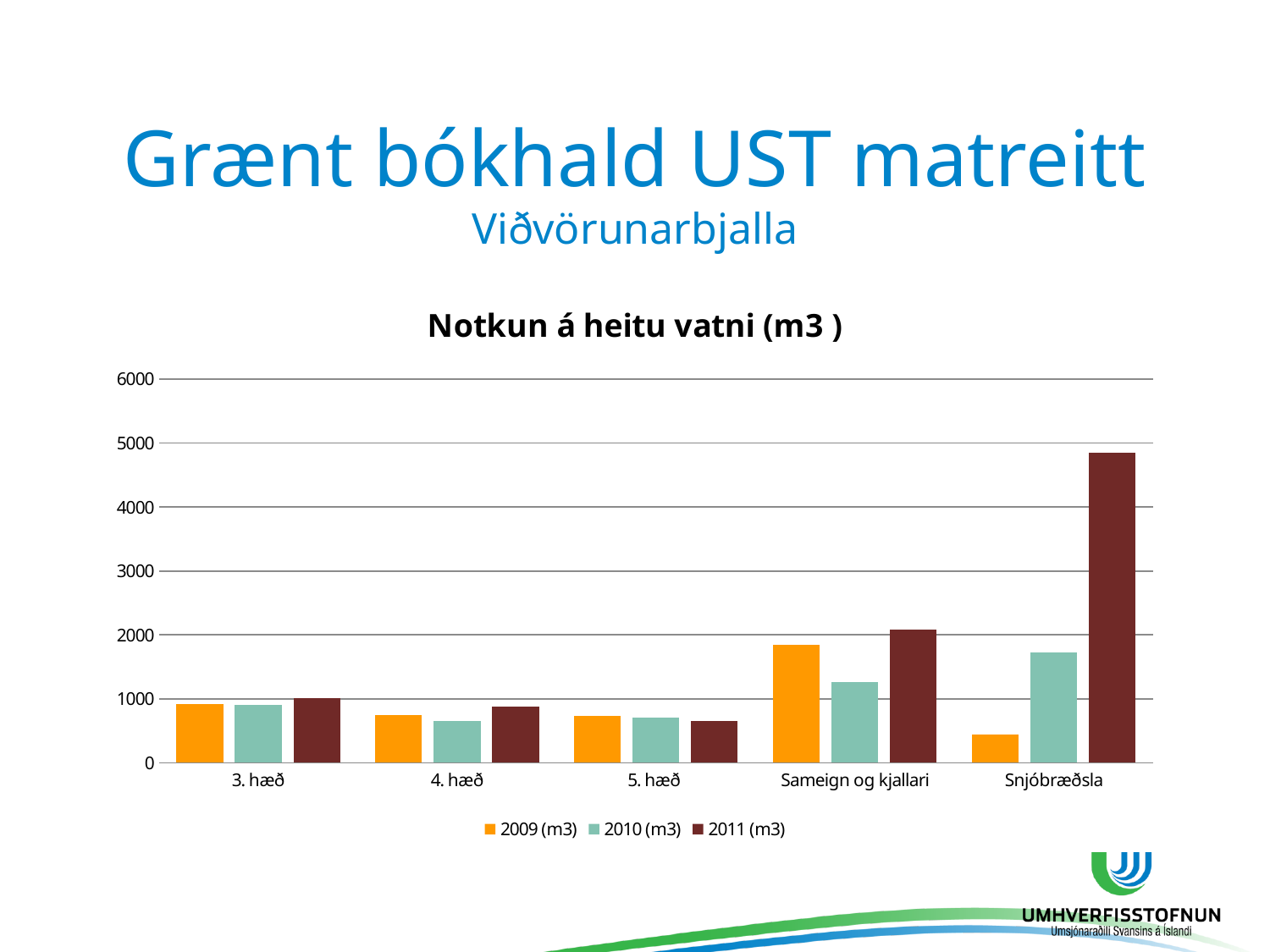
Is the 2009 (m3) value for Sameign og kjallari greater or less than 2000? less What is the title of the chart? Notkun á heitu vatni (m3 ) How many categories are shown on the x axis of the chart? 5 Which category has the lowest value for 2009 (m3)? Snjóbræðsla For Sameign og kjallari, which is larger: the 2009 (m3) value or the 2010 (m3) value? 2009 (m3) How many series does the legend list? 3 What kind of chart is shown on the slide? bar chart For Snjóbræðsla, which is larger: the 2009 (m3) value or the 2010 (m3) value? 2010 (m3) Which category has the highest value for 2011 (m3)? Snjóbræðsla Is the 2011 (m3) value for Snjóbræðsla greater or less than 4000? greater Do the values for Snjóbræðsla rise or fall from 2009 to 2011? rise Is the 2010 (m3) value for 4. hæð greater or less than 1000? less